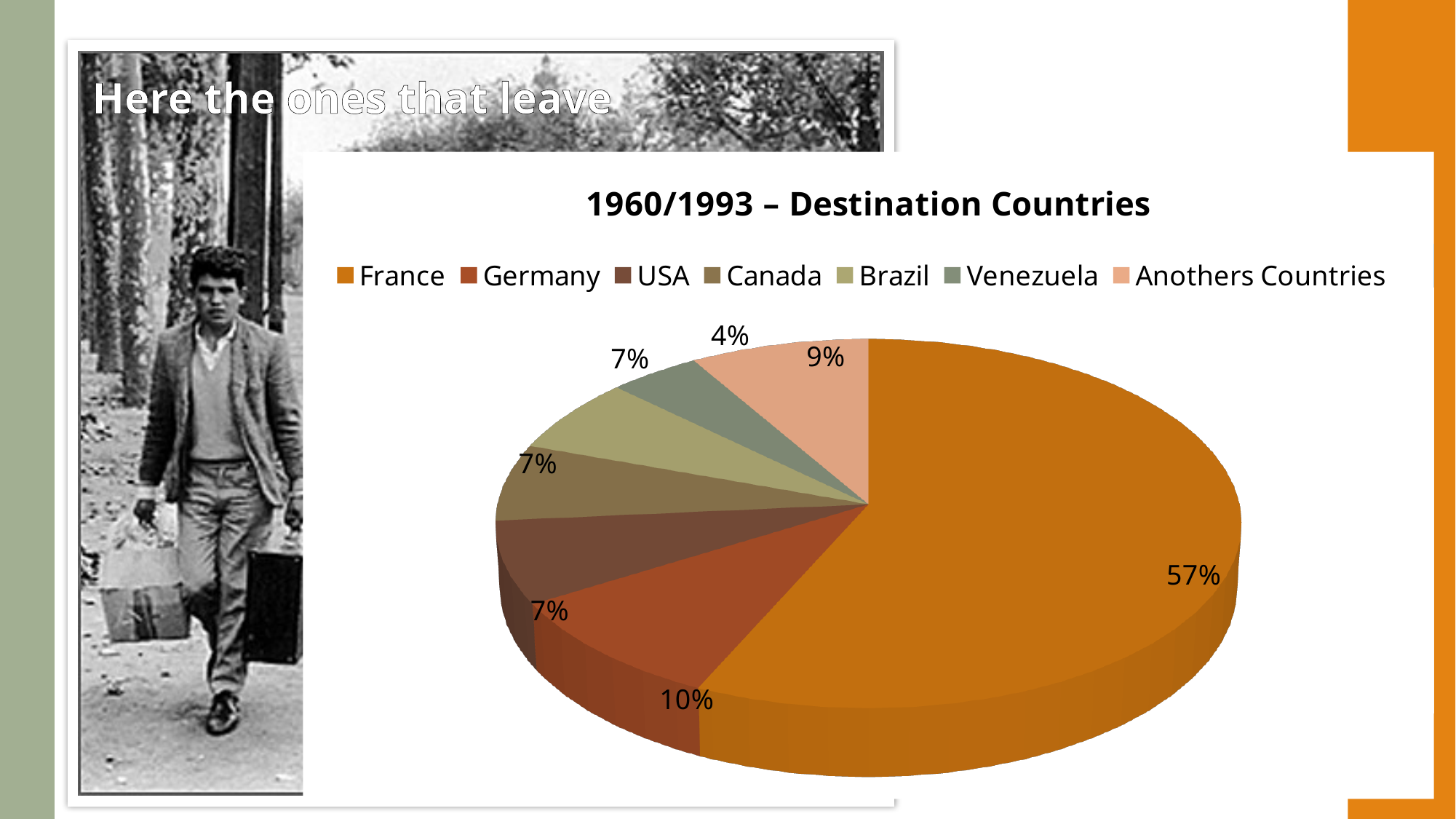
Which destination country has the smallest share of the pie? Venezuela What is the title of the chart? 1960/1993 – Destination Countries What kind of chart is shown on the slide? pie chart What share of the pie does Germany have? 10% What is the difference in percentage points between the shares of France and Germany? 47 What share of the pie does Brazil have? 7% Which has a larger share of the pie, Germany or Venezuela? Germany What share of the pie does Anothers Countries have? 9% What share of the pie does Venezuela have? 4% What share of the pie does France have? 57% How many categories does the legend of the pie chart list? 7 Which destination country has the largest share of the pie? France